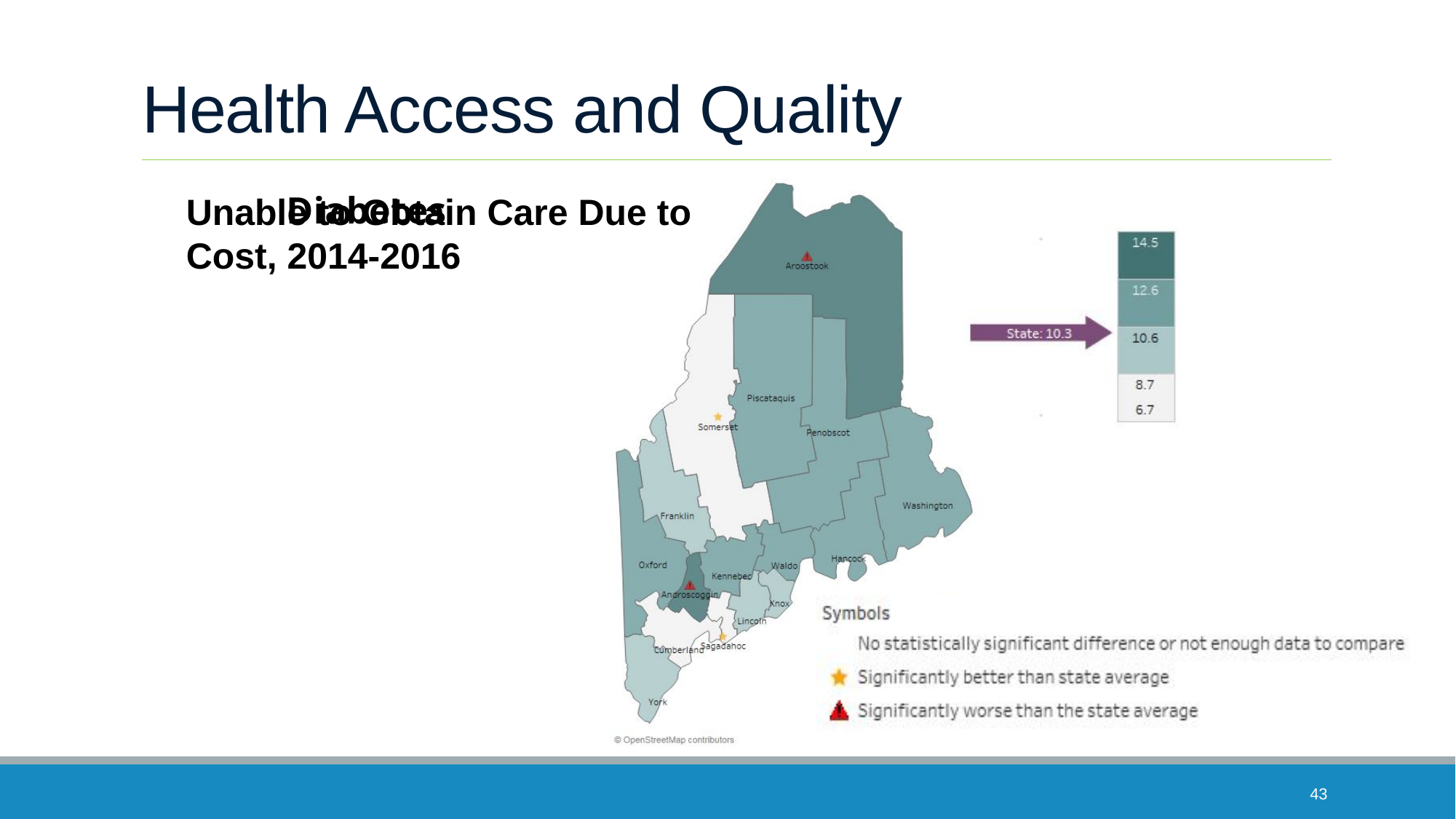
Which counties are marked with a red triangle as significantly worse than the state average? Aroostook and Androscoggin What is the state value shown by the arrow next to the legend? State: 10.3 What years does the map's title say the data covers? 2014-2016 What kind of chart is shown on the slide? map (choropleth map of Maine counties) Is the value for Somerset greater or less than the state value of 10.3? less How many symbol types are explained in the Symbols key? 3 Which counties are marked with a star as significantly better than the state average? Somerset and Sagadahoc Is the value for Aroostook greater or less than the state value of 10.3? greater How many counties are labelled on the map? 16 Which county is shaded darker, Aroostook or Somerset? Aroostook What is the lowest value shown on the colour legend? 6.7 What is the highest value shown on the colour legend? 14.5